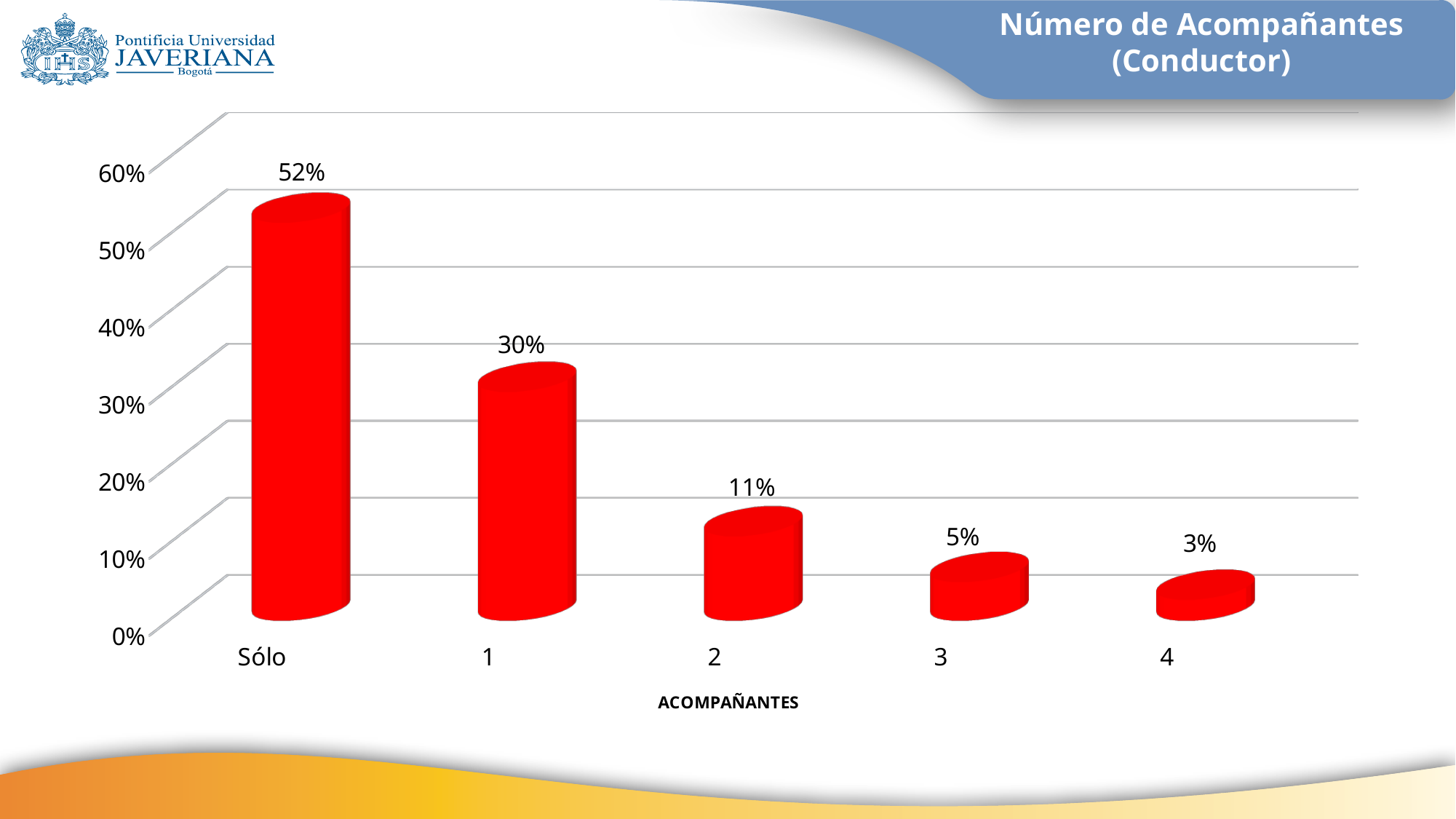
Which category has the lowest value? 4 How many categories are shown on the x axis? 5 What is the title of the chart? Número de Acompañantes (Conductor) What is the value for the 'Sólo' category? 52% Which category has the highest value? Sólo What is the value for 2 acompañantes? 11% Which is larger, the value for 2 acompañantes or for 3 acompañantes? 2 What is the difference between the values for 'Sólo' and 1 acompañante? 22% What is the value for 4 acompañantes? 3% Do the values rise or fall from left to right along the x axis? Fall What is the value for 1 acompañante? 30% What kind of chart is shown on the slide? Bar chart